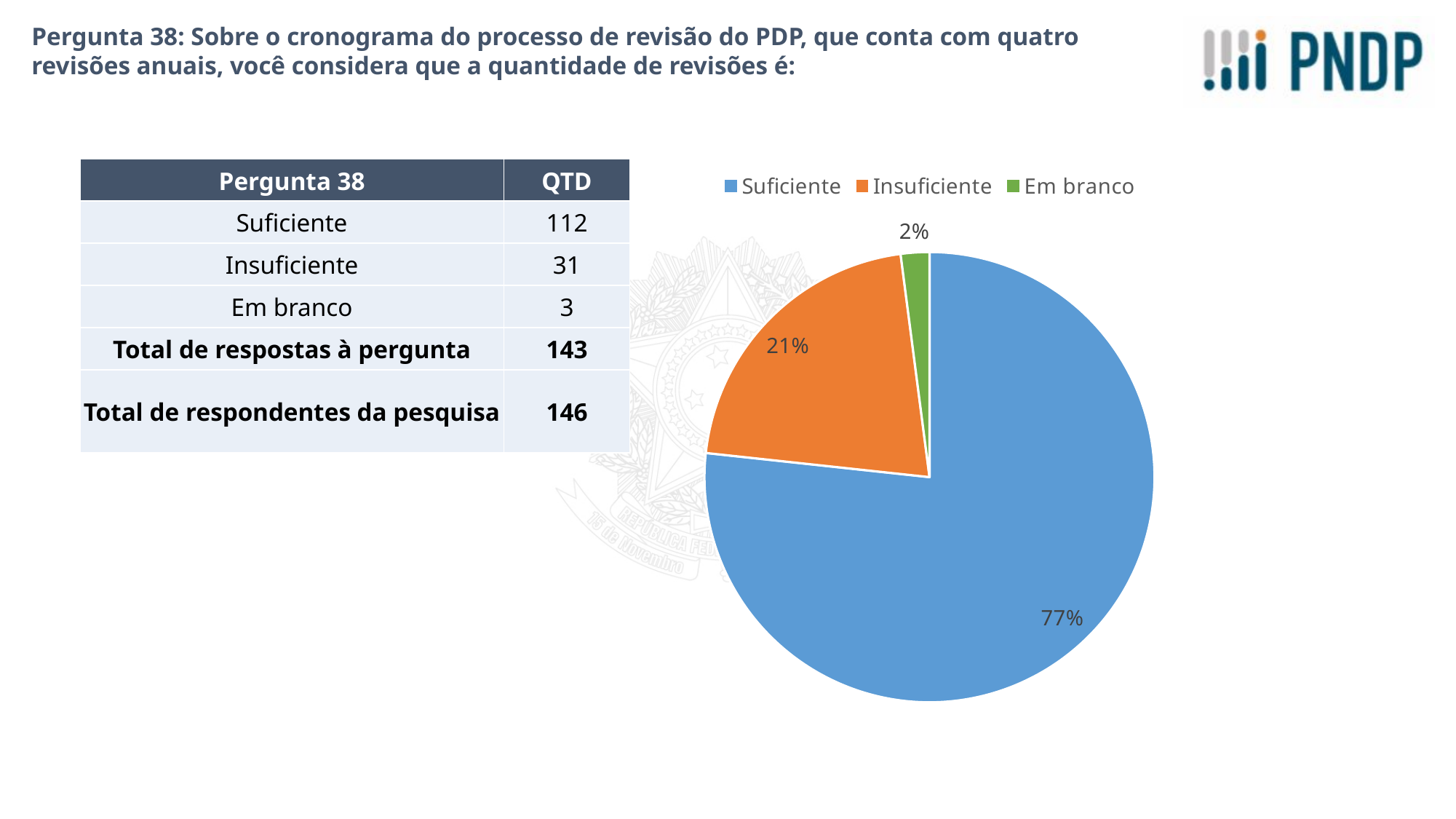
What percentage of the pie does the Suficiente slice represent? 77% What percentage of the pie does the Em branco slice represent? 2% How many entries does the legend list? 3 What kind of chart is shown on the slide? pie chart What percentage of the pie does the Insuficiente slice represent? 21% What colour is the Insuficiente slice? orange What is the difference in percentage points between the Suficiente and Insuficiente slices? 56 Which category has the smallest slice of the pie? Em branco Which legend entry is shown in green? Em branco Which slice is larger, Insuficiente or Em branco? Insuficiente How many slices does the pie chart have? 3 Which category has the largest slice of the pie? Suficiente